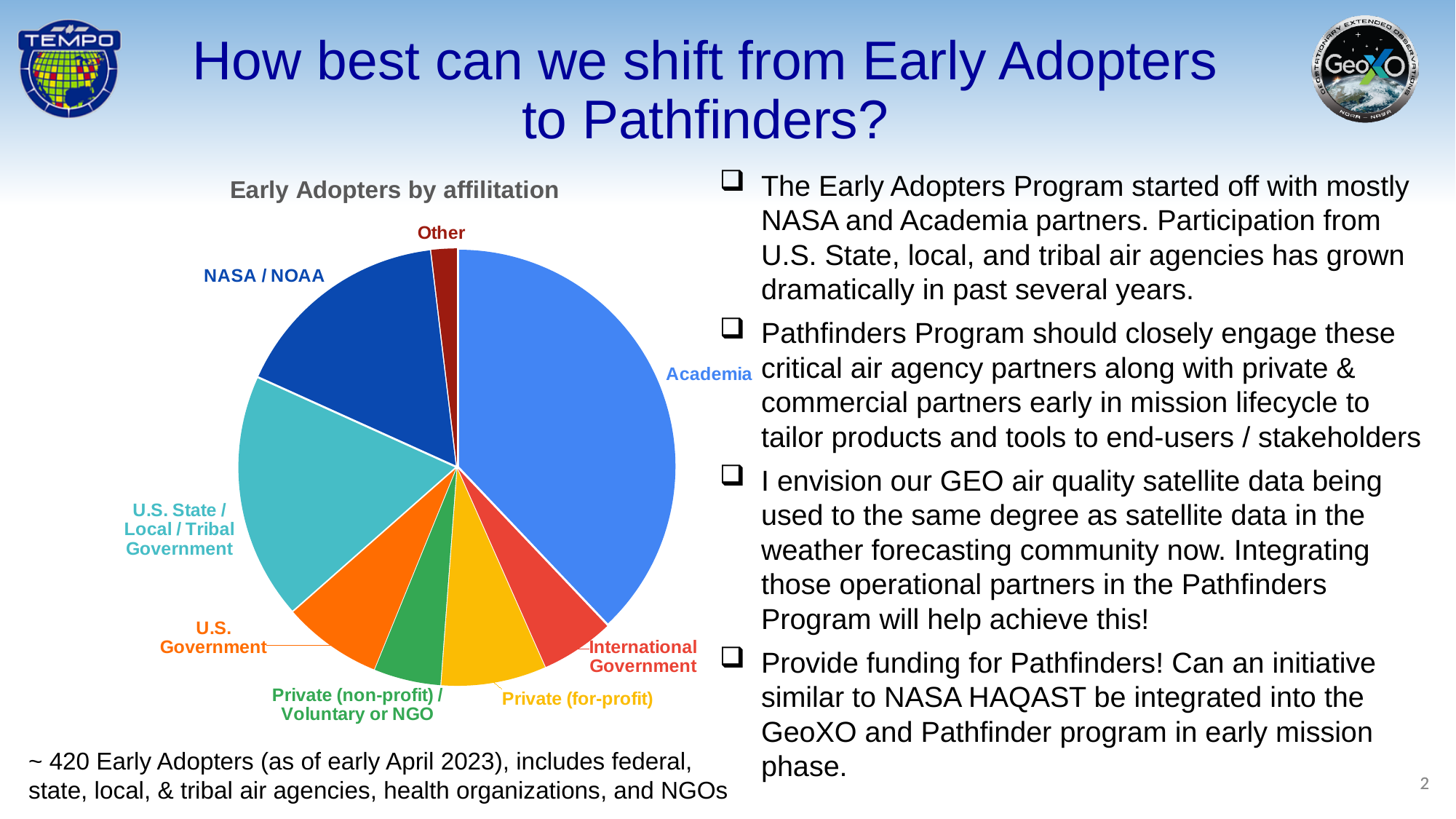
Which slice is larger: NASA / NOAA or Other? NASA / NOAA Which slice is larger: U.S. State / Local / Tribal Government or International Government? U.S. State / Local / Tribal Government What is the title of the chart on the slide? Early Adopters by affilitation Which slice is larger: U.S. State / Local / Tribal Government or U.S. Government? U.S. State / Local / Tribal Government What kind of chart is shown on the slide? Pie chart Which affiliation category has the largest slice of the pie chart? Academia Which affiliation category has the smallest slice of the pie chart? Other How many affiliation categories (slices) does the pie chart show? 8 What colour is the Academia slice in the pie chart? Blue